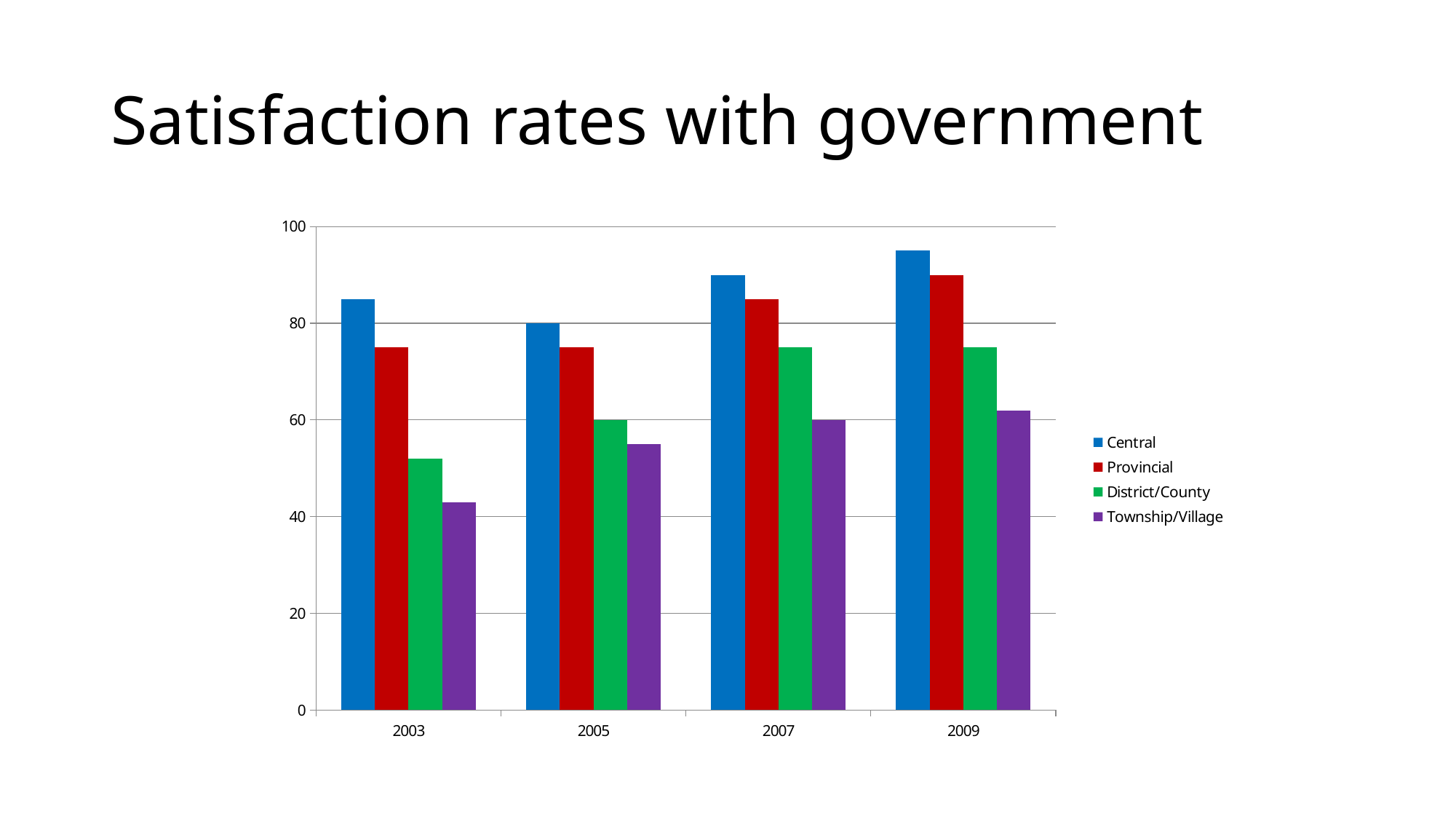
How many years are shown on the x axis? 4 Which series has the highest value in 2009? Central How many series does the legend list? 4 What is the value for Central in 2005? 80 What is the title of the chart? Satisfaction rates with government Is the value for Central in 2003 greater or less than 80? greater What is the value for District/County in 2005? 60 Which series has the lowest value in 2003? Township/Village Do the Township/Village values rise or fall from 2003 to 2009? rise Is the value for Provincial in 2009 greater or less than 80? greater Is the value for District/County in 2003 greater or less than 60? less What kind of chart is shown on the slide? bar chart